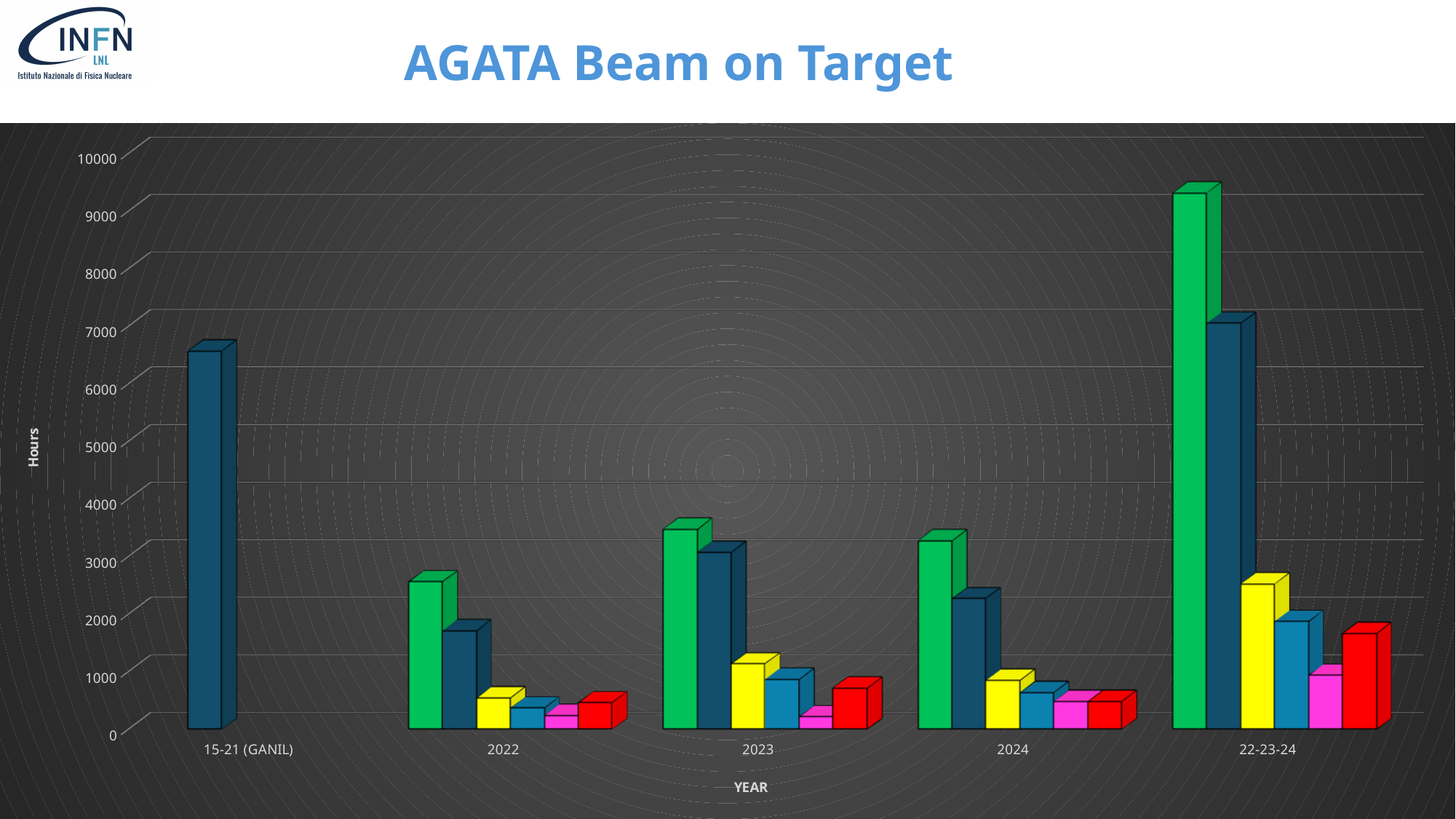
Which is larger, the green bar for 2022 or the green bar for 2023? 2023 Is the value of the green bar for 22-23-24 greater or less than 8000? greater Is the value of the bar for 15-21 (GANIL) greater or less than 7000? less What is the title of the x axis? YEAR How many categories are shown on the x axis? 5 Is the value of the green bar for 2022 greater or less than 3000? less How many bars are shown for the 22-23-24 category? 6 Which is larger, the dark blue bar for 2023 or the dark blue bar for 2024? 2023 Which category contains the tallest bar? 22-23-24 What kind of chart is shown on the slide? bar chart